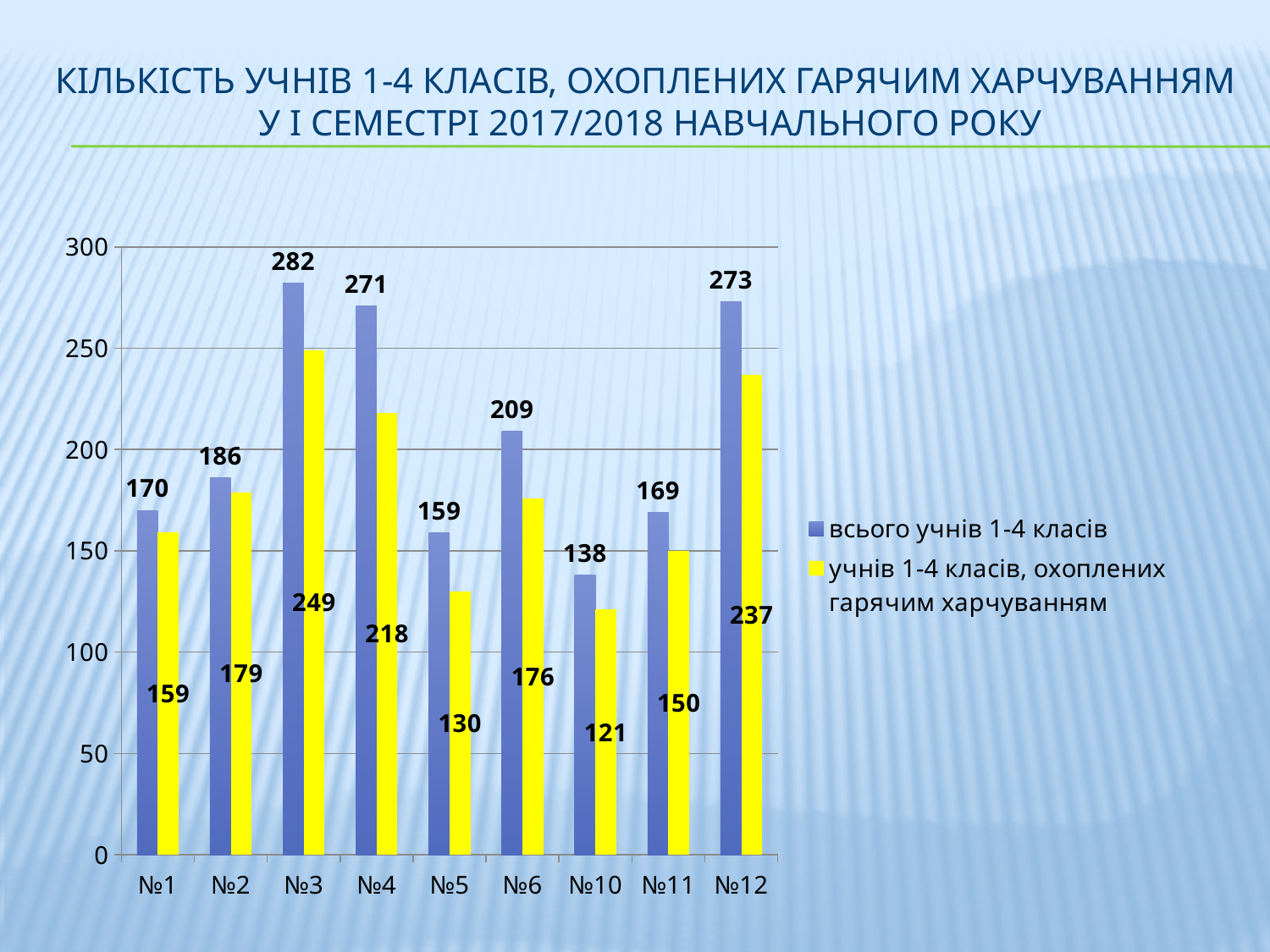
Which category has the highest value in the series "всього учнів 1-4 класів"? №3 What is the value for №3 in the series "всього учнів 1-4 класів"? 282 How many series does the legend list? 2 What is the difference between the two series for №4? 53 What kind of chart is shown on the slide? bar chart What colour are the bars for the series "учнів 1-4 класів, охоплених гарячим харчуванням"? yellow What is the value for №5 in the series "учнів 1-4 класів, охоплених гарячим харчуванням"? 130 How many categories are shown on the x axis? 9 Which category has the lowest value in the series "учнів 1-4 класів, охоплених гарячим харчуванням"? №10 What is the value for №12 in the series "учнів 1-4 класів, охоплених гарячим харчуванням"? 237 Is the value for №2 in the series "всього учнів 1-4 класів" greater or less than 200? less Which is larger: the value for №6 or the value for №11 in the series "всього учнів 1-4 класів"? №6